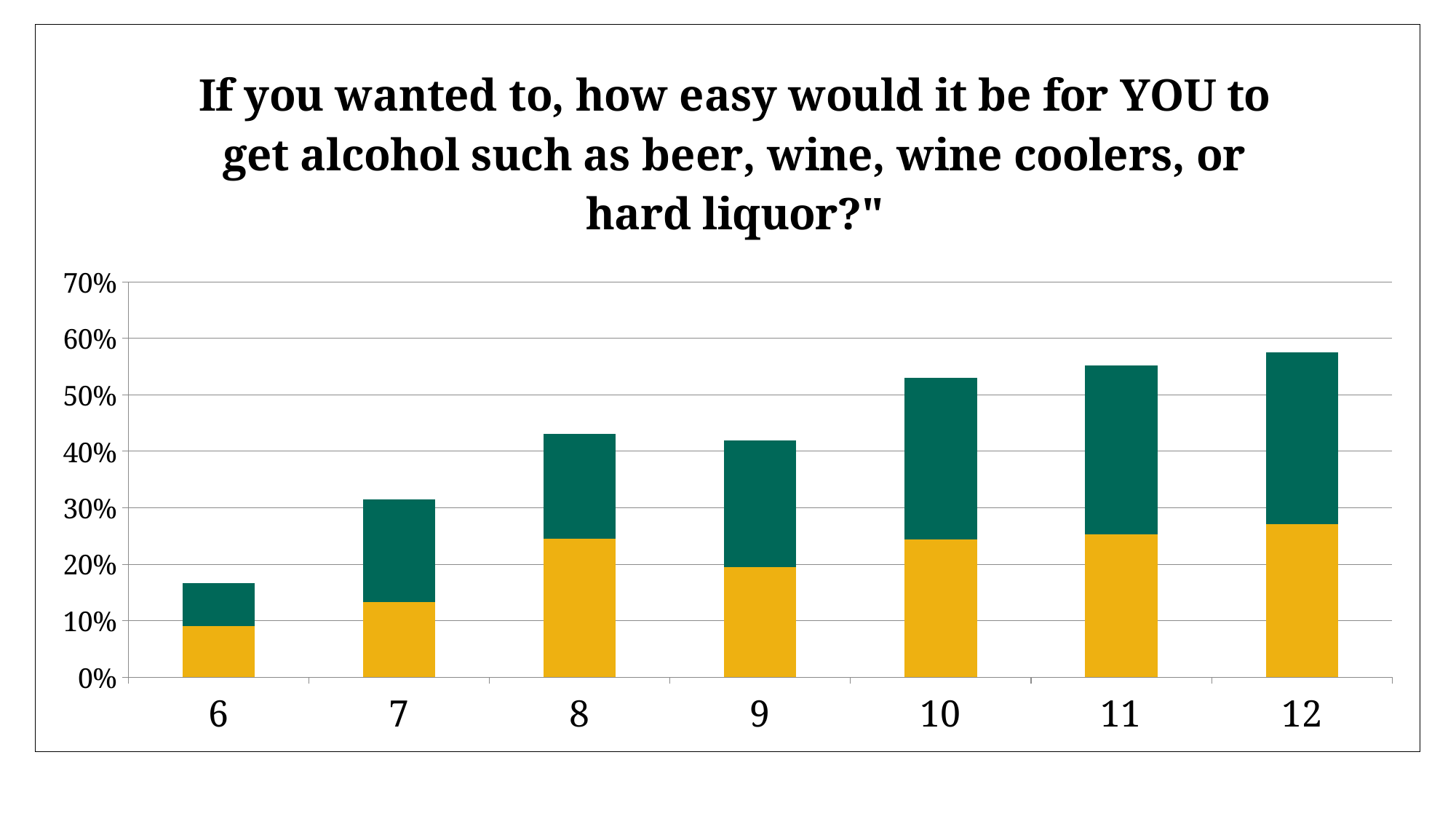
Is the total stacked bar for grade 6 greater or less than 20%? less Is the total stacked bar for grade 7 greater or less than 40%? less What is the title of the chart? If you wanted to, how easy would it be for YOU to get alcohol such as beer, wine, wine coolers, or hard liquor?" Which has the taller stacked bar, grade 7 or grade 10? 10 How many grade categories are shown on the x axis? 7 Do the stacked bar totals generally rise or fall from grade 6 to grade 12? rise Is the total stacked bar for grade 12 greater or less than 50%? greater Which grade has the shortest stacked bar? 6 What kind of chart is shown on the slide? stacked bar chart Which grade has the tallest stacked bar? 12